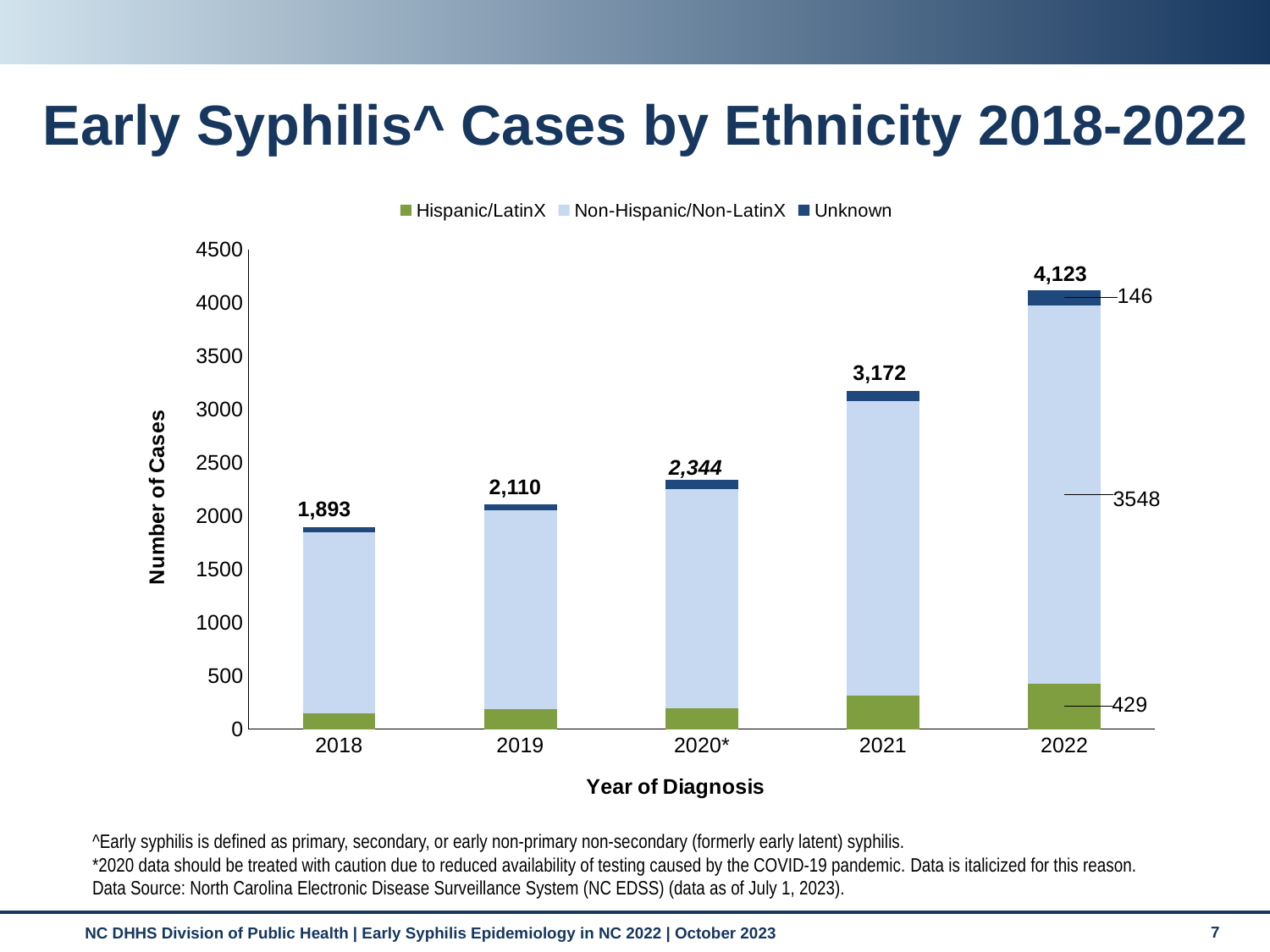
How many cases of Unknown ethnicity are labeled for 2022? 146 Do the total early syphilis cases rise or fall from 2018 to 2022? rise What is the total number of early syphilis cases shown for 2022? 4,123 What is the difference between the total cases in 2022 and 2021? 951 How many Hispanic/LatinX cases are labeled for 2022? 429 Which year has more total cases, 2019 or 2020*? 2020* How many Non-Hispanic/Non-LatinX cases are labeled for 2022? 3548 How many years are shown on the x axis? 5 Which year has the highest total number of early syphilis cases? 2022 What is the total number of early syphilis cases shown for 2018? 1,893 Which year has the lowest total number of early syphilis cases? 2018 How many series does the legend list? 3